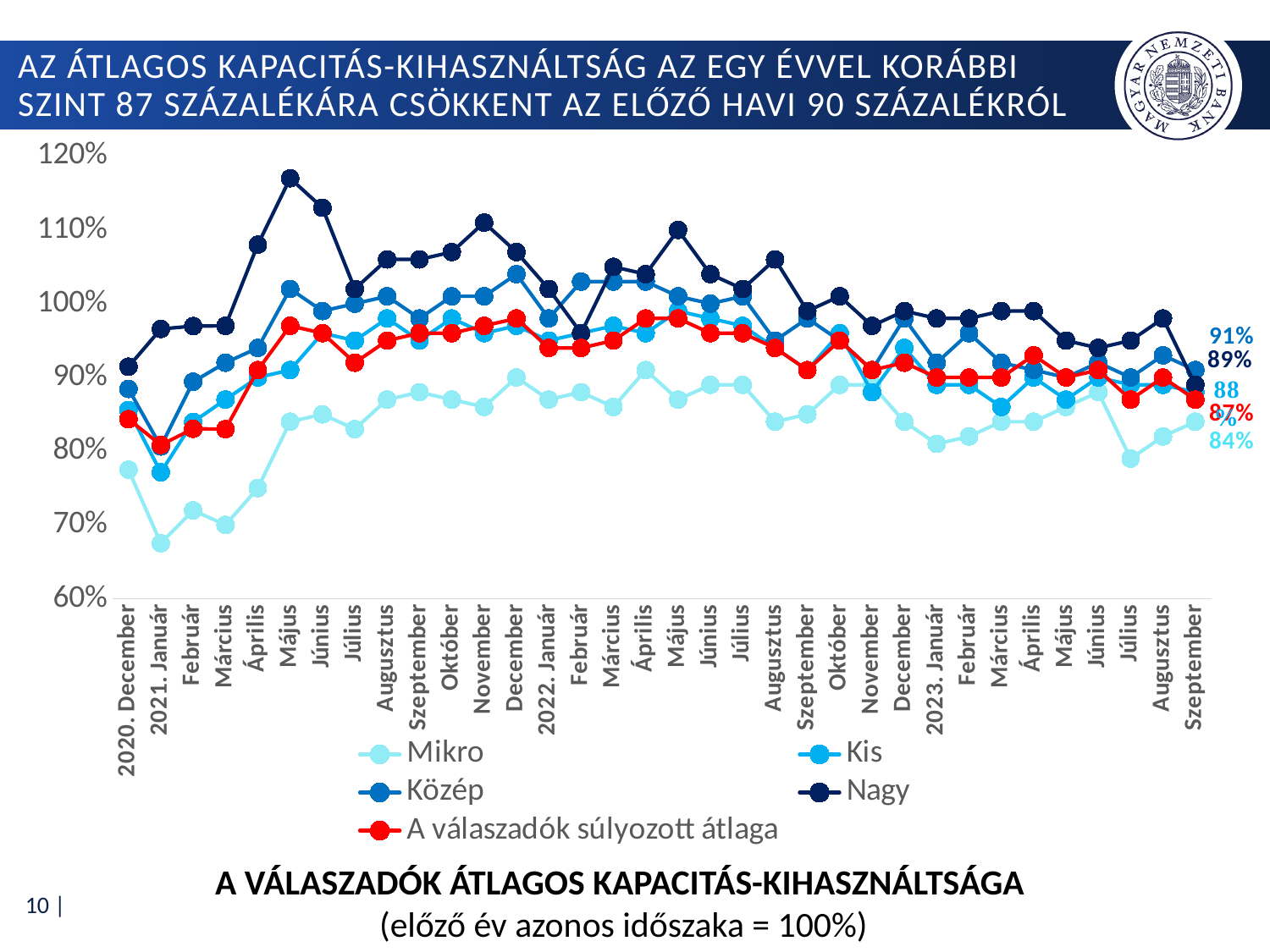
Which series has the lowest value at the last point (2023 Szeptember)? Mikro What is the value of the Mikro series at the last point (2023 Szeptember)? 84% In which month does the Nagy series reach its highest value? 2021 Május Is the value for Nagy in 2021 Május greater or less than 110%? greater In which month does the Mikro series reach its lowest value? 2021 Január What is the title printed below the chart? A válaszadók átlagos kapacitás-kihasználtsága (előző év azonos időszaka = 100%) Which is larger in 2021 Május: the Nagy value or the Mikro value? Nagy How many series does the legend list? 5 Is the value for Mikro in 2021 Január greater or less than 70%? less What is the value of 'A válaszadók súlyozott átlaga' at the last point (2023 Szeptember)? 87% What kind of chart is shown on the slide? line chart Does the Mikro series rise or fall between 2020 December and 2021 Május? rise